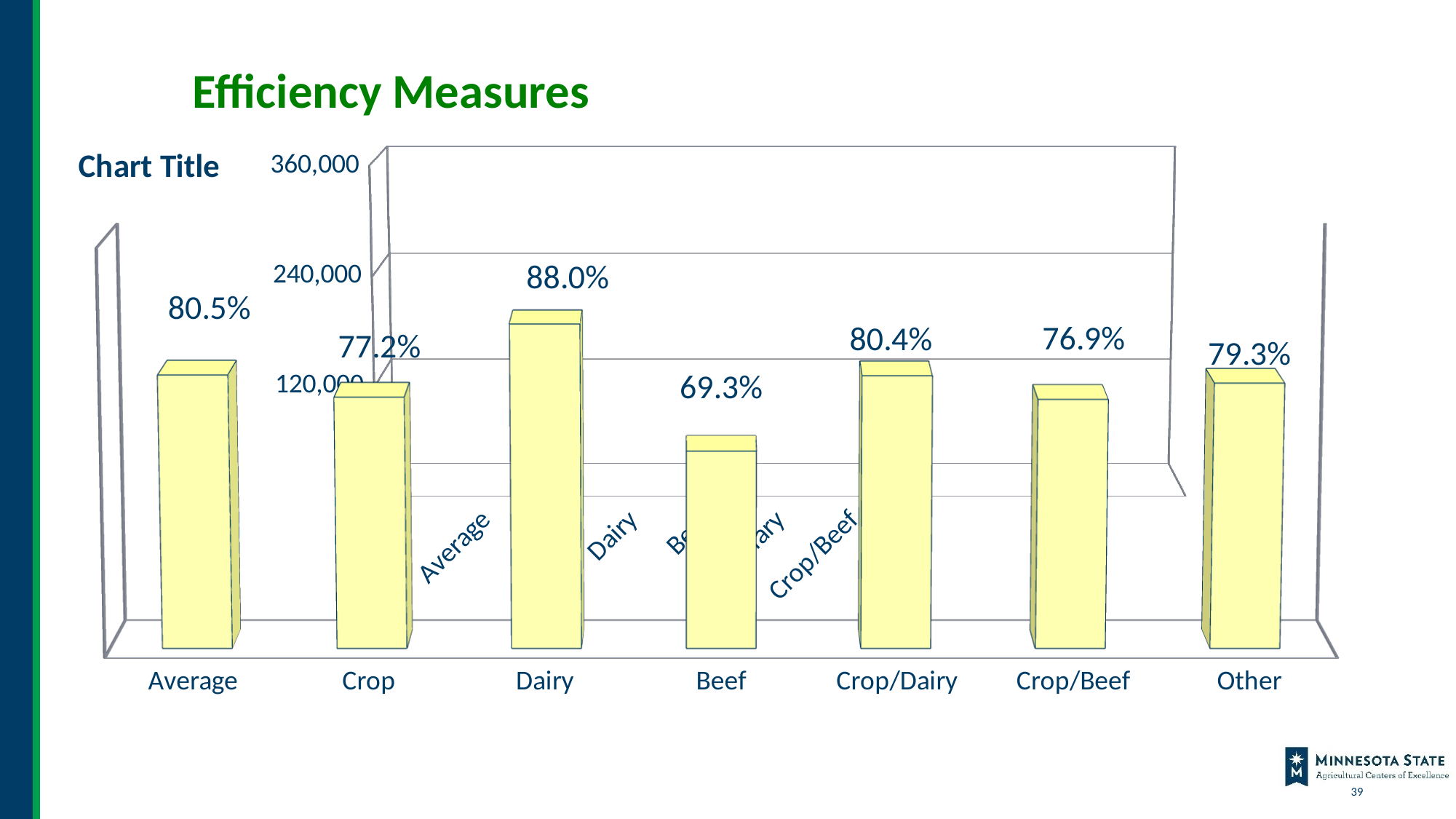
What is the value for Crop/Beef? 76.9% What kind of chart is shown on the slide? Bar chart What is the value for Average? 80.5% What is the value for Other? 79.3% Which is larger, the value for Crop/Dairy or the value for Crop/Beef? Crop/Dairy What is the value for Beef? 69.3% What is the difference between the values for Crop and Crop/Beef? 0.3% What is the difference between the values for Dairy and Beef? 18.7% How many categories are shown on the x axis? 7 Which category has the highest value? Dairy What is the value for Dairy? 88.0% Which category has the lowest value? Beef